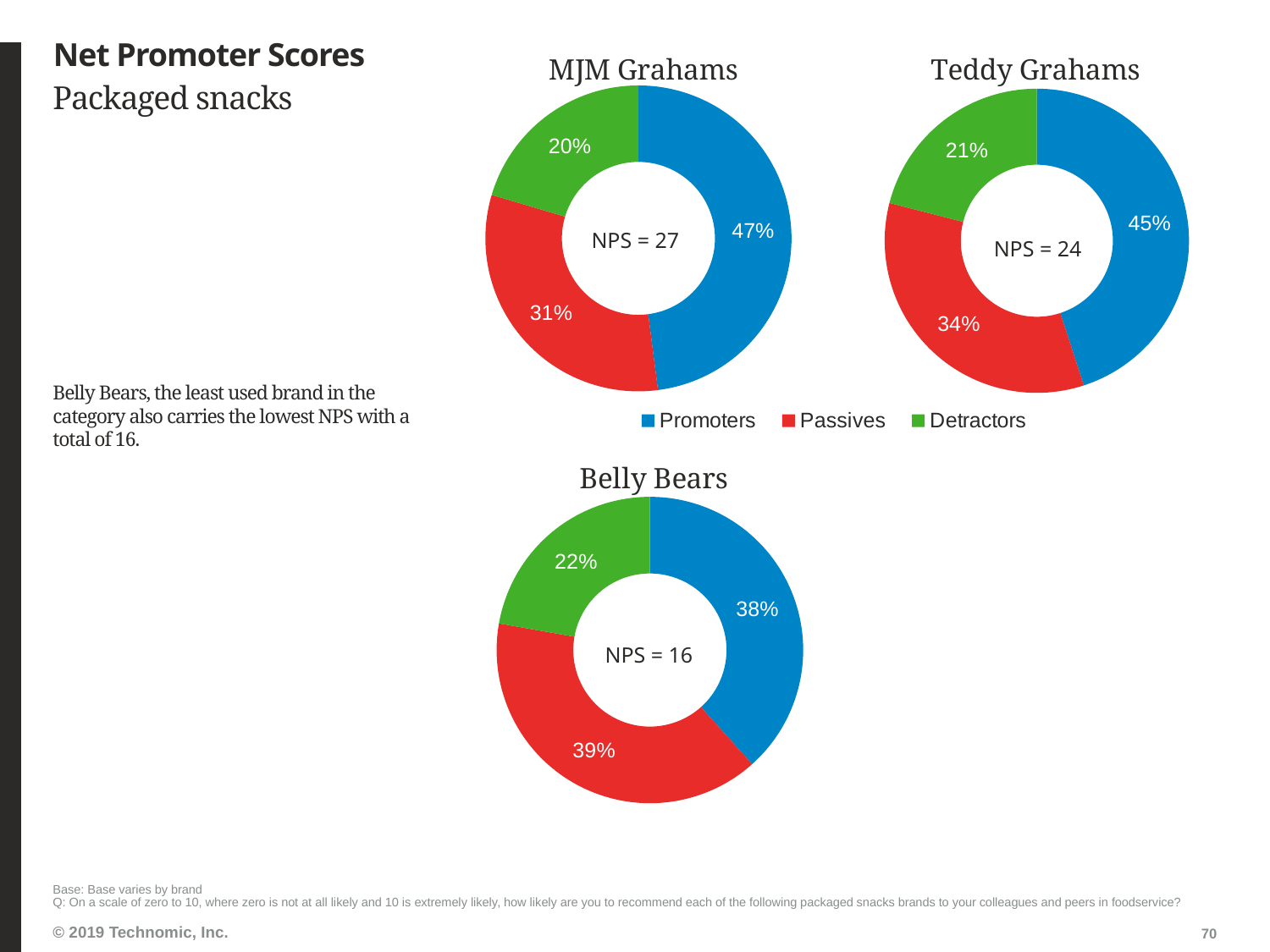
In the Belly Bears chart, what percentage are Detractors? 22% How many entries does the shared legend list? 3 In the MJM Grahams chart, what percentage are Promoters? 47% In the Belly Bears chart, which category has the largest share? Passives Which colour represents Passives in the legend? Red In the MJM Grahams chart, which category has the smallest share? Detractors In the Teddy Grahams chart, what is the difference between the Promoters and Detractors percentages? 24% What NPS value is shown in the center of the MJM Grahams chart? NPS = 27 In the Teddy Grahams chart, what percentage are Passives? 34% How many slices does the Teddy Grahams chart have? 3 What type of chart is used for Belly Bears? Doughnut chart Which chart shows a higher Promoters percentage, MJM Grahams or Belly Bears? MJM Grahams